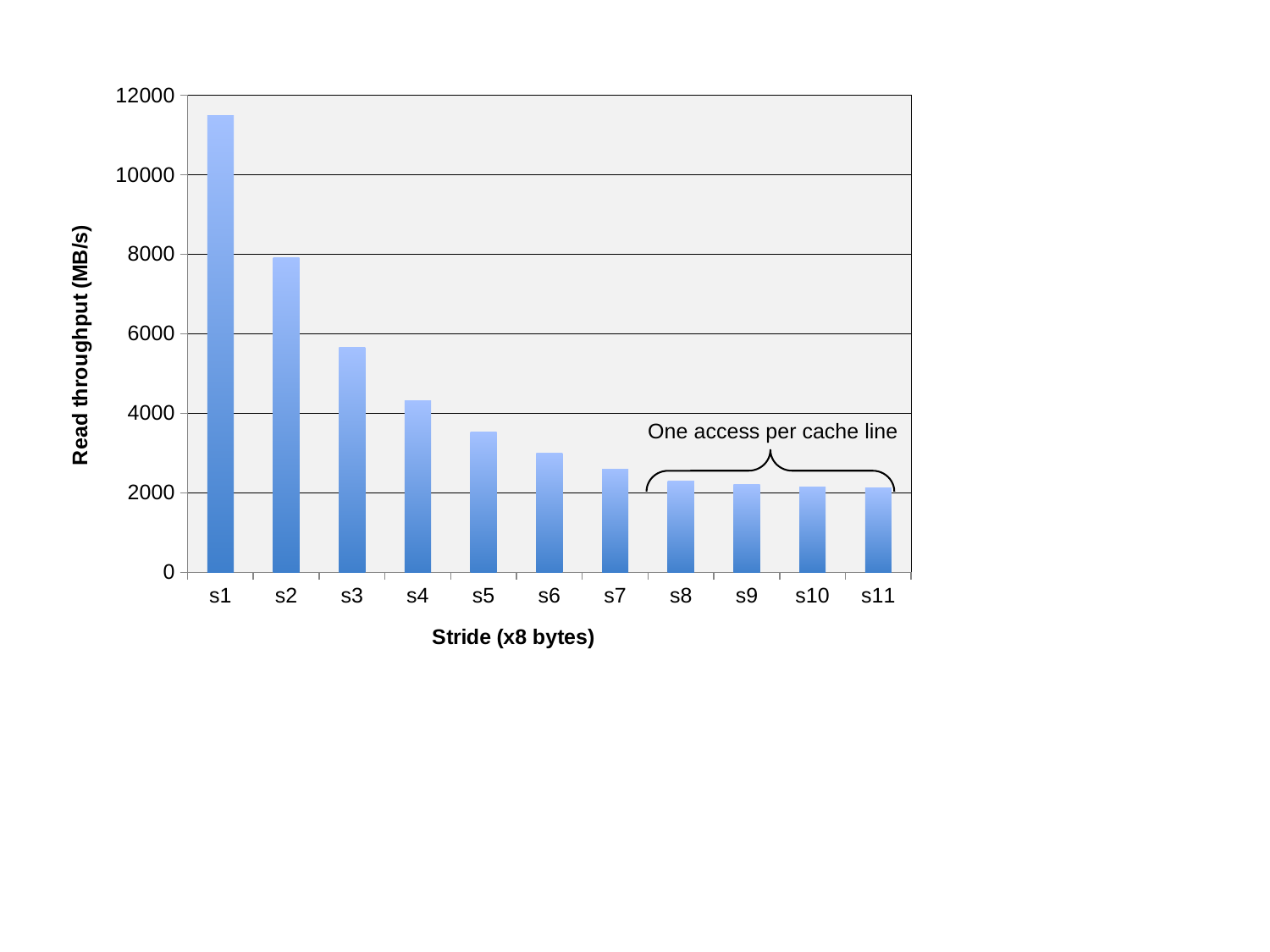
Is the read throughput for s2 greater or less than 6000? greater Is the read throughput for s8 greater or less than 2000? greater Which stride has the highest read throughput? s1 How many stride categories are plotted on the x axis? 11 What does the annotation above the bars for s8 to s11 say? One access per cache line What kind of chart is shown on the slide? bar chart Which has the higher read throughput, s3 or s4? s3 Is the read throughput for s5 greater or less than 4000? less What is the label on the y axis? Read throughput (MB/s) Do the read throughput values rise or fall as the stride increases from s1 to s11? fall